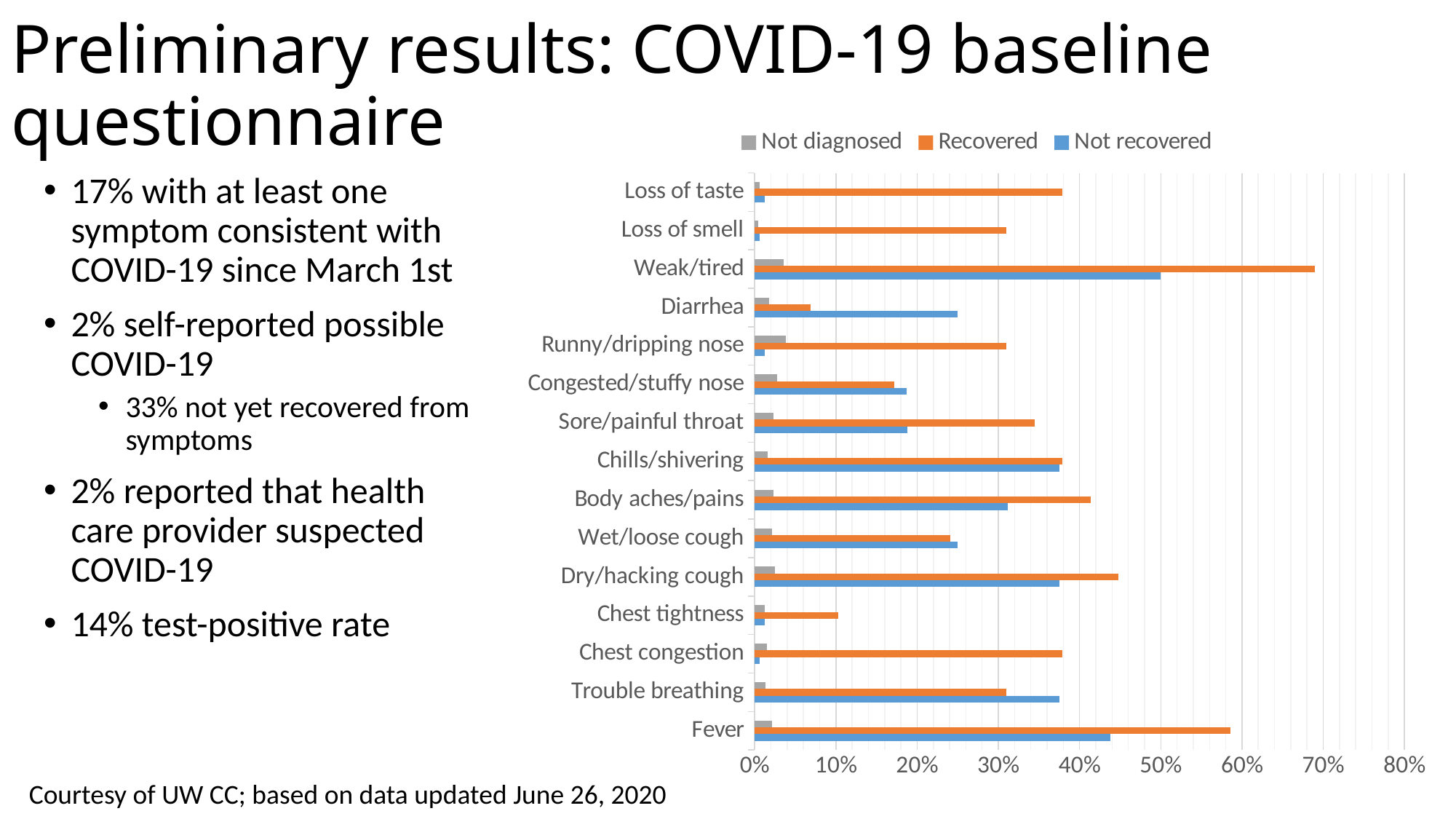
Which symptom has the highest Not recovered value? Weak/tired Which series is shown in orange in the chart legend? Recovered For Fever, which is larger: the Recovered value or the Not recovered value? Recovered Which symptom has the highest Recovered value? Weak/tired What kind of chart is shown on the slide? bar chart How many series does the chart legend list? 3 Is the Recovered value for Weak/tired greater or less than 60%? greater How many symptom categories are plotted on the chart? 15 Is the Recovered value for Fever greater or less than 50%? greater Is the Not recovered value for Diarrhea greater or less than 20%? greater For Diarrhea, which is larger: the Recovered value or the Not recovered value? Not recovered